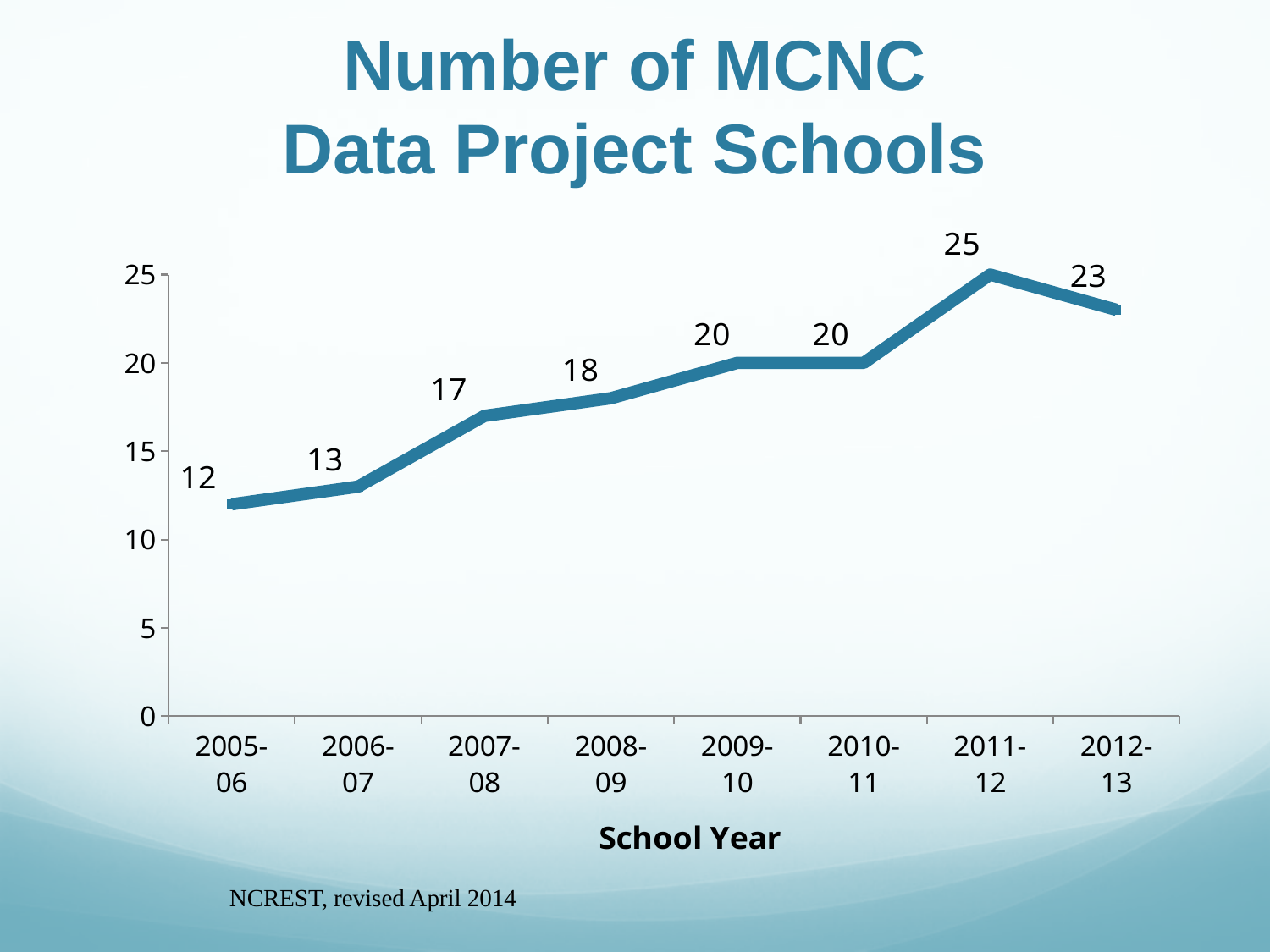
How many MCNC Data Project Schools were there in 2005-06? 12 Which school year has the lowest number of MCNC Data Project Schools? 2005-06 What is the difference between the values for 2011-12 and 2005-06? 13 What type of chart is shown on the slide? line chart What is the label of the x axis? School Year Which is larger, the value for 2011-12 or the value for 2012-13? 2011-12 What is the difference between the values for 2007-08 and 2006-07? 4 Which school year has the highest number of MCNC Data Project Schools? 2011-12 What is the value for 2008-09? 18 How many school years are plotted on the chart? 8 Does the number of schools generally rise or fall from 2005-06 to 2011-12? rise What is the value for 2012-13? 23